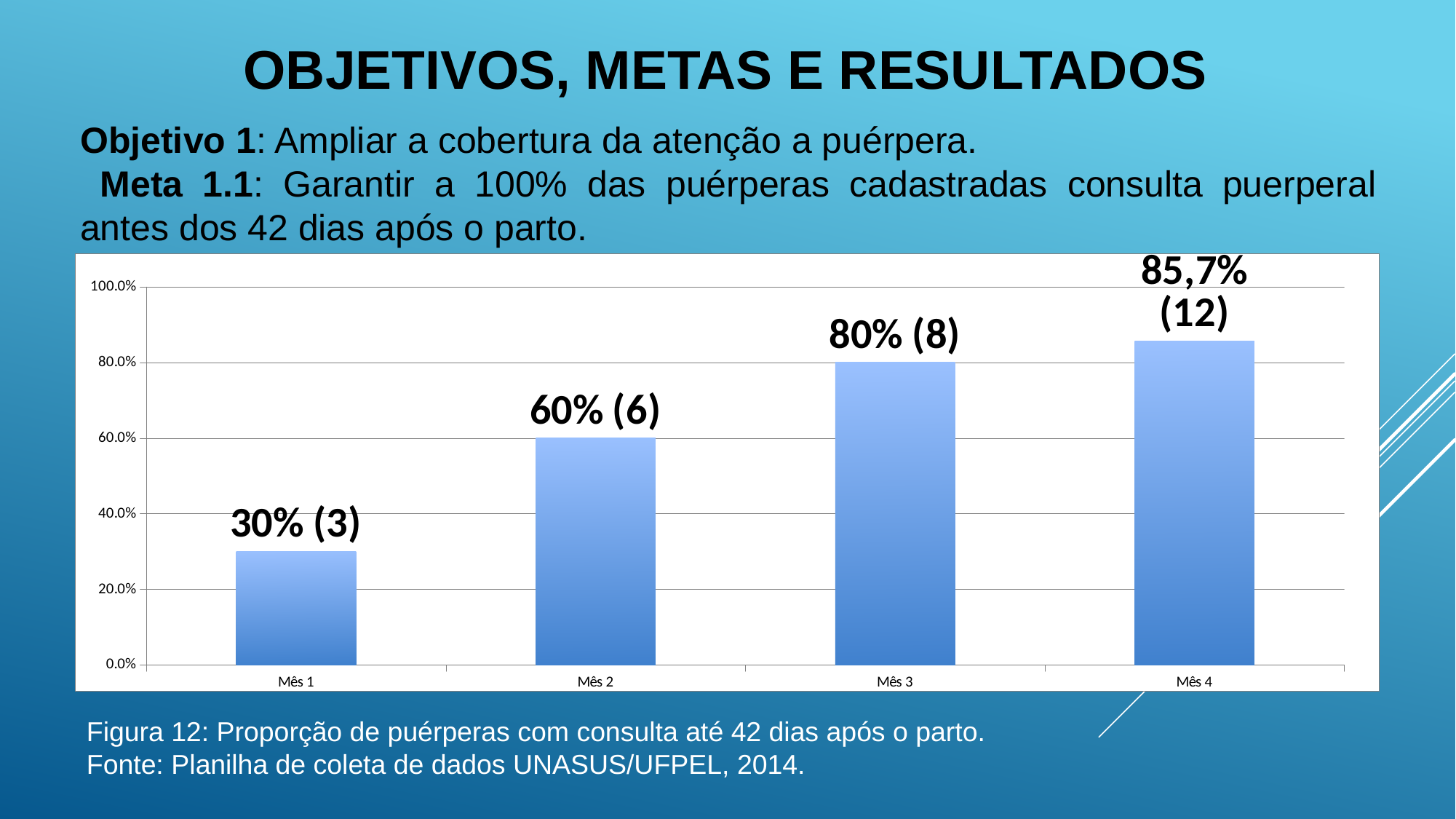
Which month has the highest value? Mês 4 What is the value shown for Mês 4? 85,7% (12) What is the value shown for Mês 2? 60% (6) What is the value shown for Mês 1? 30% (3) Which month has the lowest value? Mês 1 What is the value shown for Mês 3? 80% (8) Which is larger, the value for Mês 2 or the value for Mês 3? Mês 3 What is the difference in percentage between Mês 3 and Mês 1? 50% Do the values rise or fall from Mês 1 to Mês 4? rise Is the value for Mês 4 greater or less than 80.0%? greater How many months are shown on the x axis? 4 What kind of chart is shown on the slide? bar chart